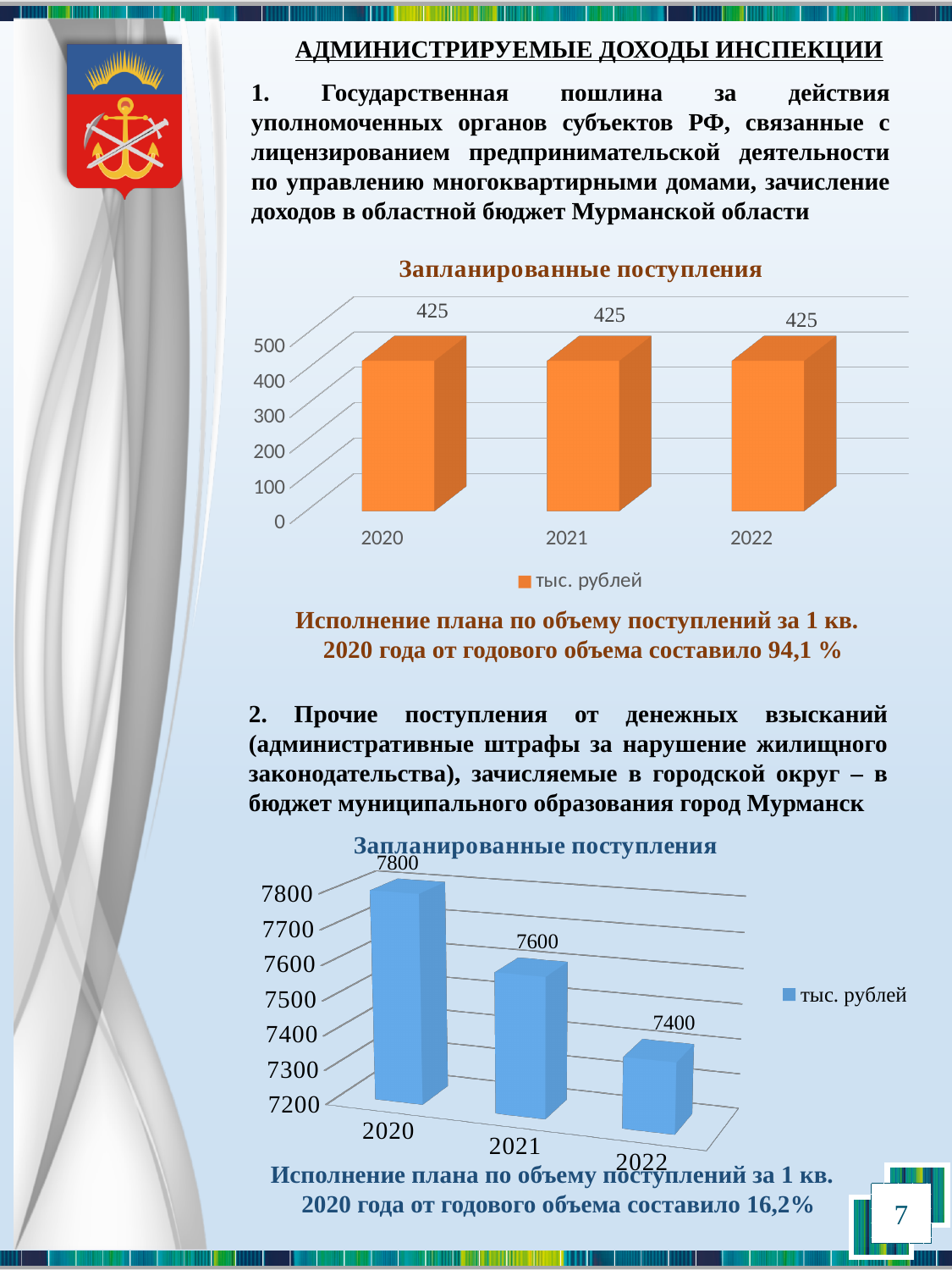
In the top chart (orange bars), what series name does the legend show? тыс. рублей In the bottom chart (blue bars), do the values rise or fall from 2020 to 2022? fall In the top chart (orange bars), how many categories are shown on the x axis? 3 In the bottom chart (blue bars), which year has the highest value? 2020 What type of chart is the bottom chart on the slide? bar chart In the bottom chart (Запланированные поступления, blue bars), what is the value for 2020? 7800 In the top chart (orange bars), what is the value for 2022? 425 In the bottom chart (blue bars), what is the difference between the values for 2020 and 2022? 400 In the bottom chart (blue bars), what is the value for 2022? 7400 In the top chart (Запланированные поступления, orange bars), what is the value for 2020? 425 In the bottom chart (blue bars), which year has the lowest value? 2022 In the top chart (orange bars), what is the difference between the values for 2021 and 2020? 0